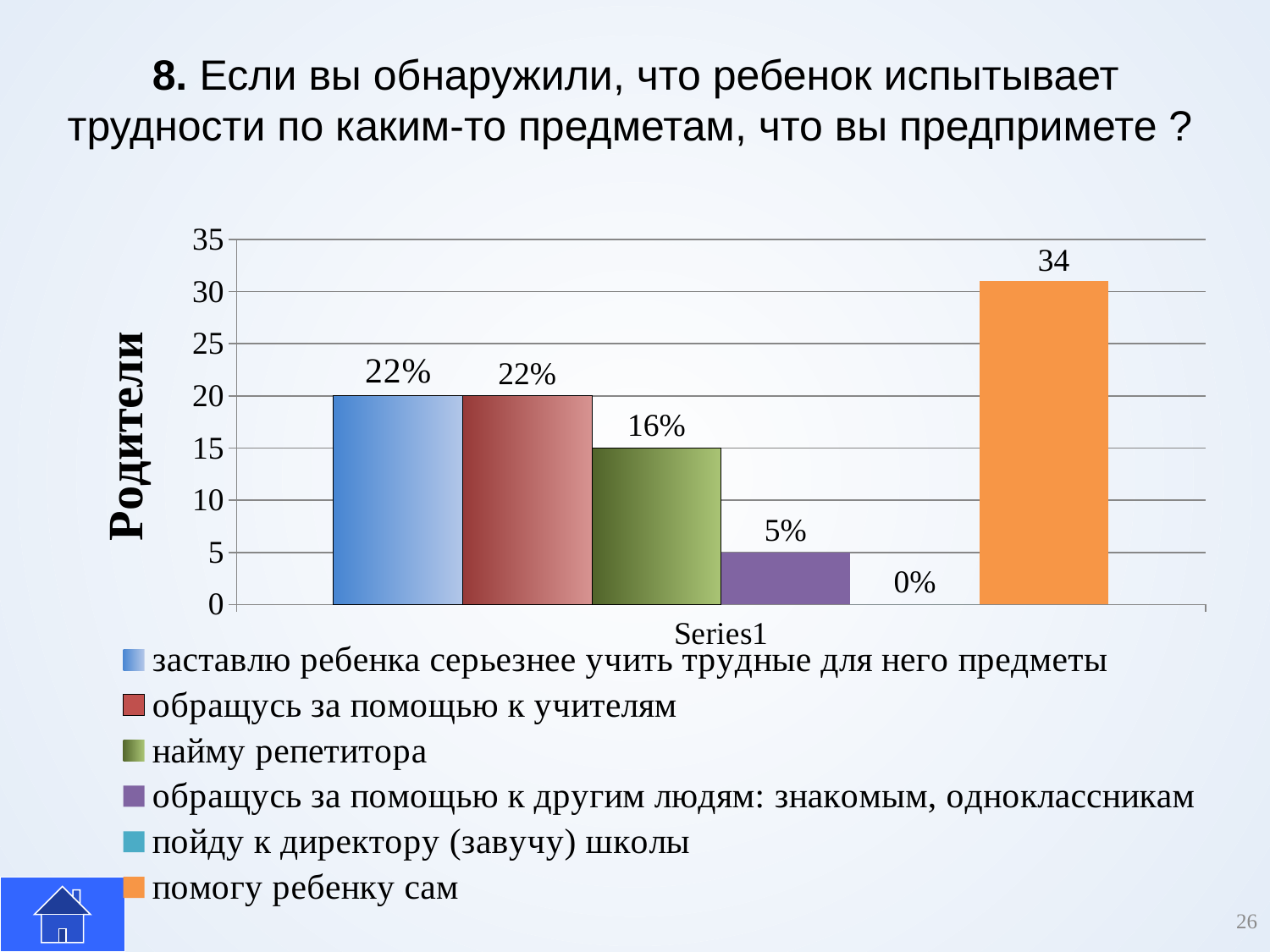
Which is larger: the value for "заставлю ребенка серьезнее учить трудные для него предметы" or for "найму репетитора"? заставлю ребенка серьезнее учить трудные для него предметы Which category has the lowest value? пойду к директору (завучу) школы What value is shown for "пойду к директору (завучу) школы"? 0% Is the value for "помогу ребенку сам" greater or less than 30? greater What value is shown for "обращусь за помощью к учителям"? 22% What value is shown for "обращусь за помощью к другим людям: знакомым, одноклассникам"? 5% What kind of chart is shown on the slide? bar chart What value is shown for "помогу ребенку сам"? 34 Which category has the highest value? помогу ребенку сам What is the difference between the values for "найму репетитора" and "обращусь за помощью к другим людям: знакомым, одноклассникам"? 11% How many categories are listed in the legend? 6 What value is shown for "найму репетитора"? 16%